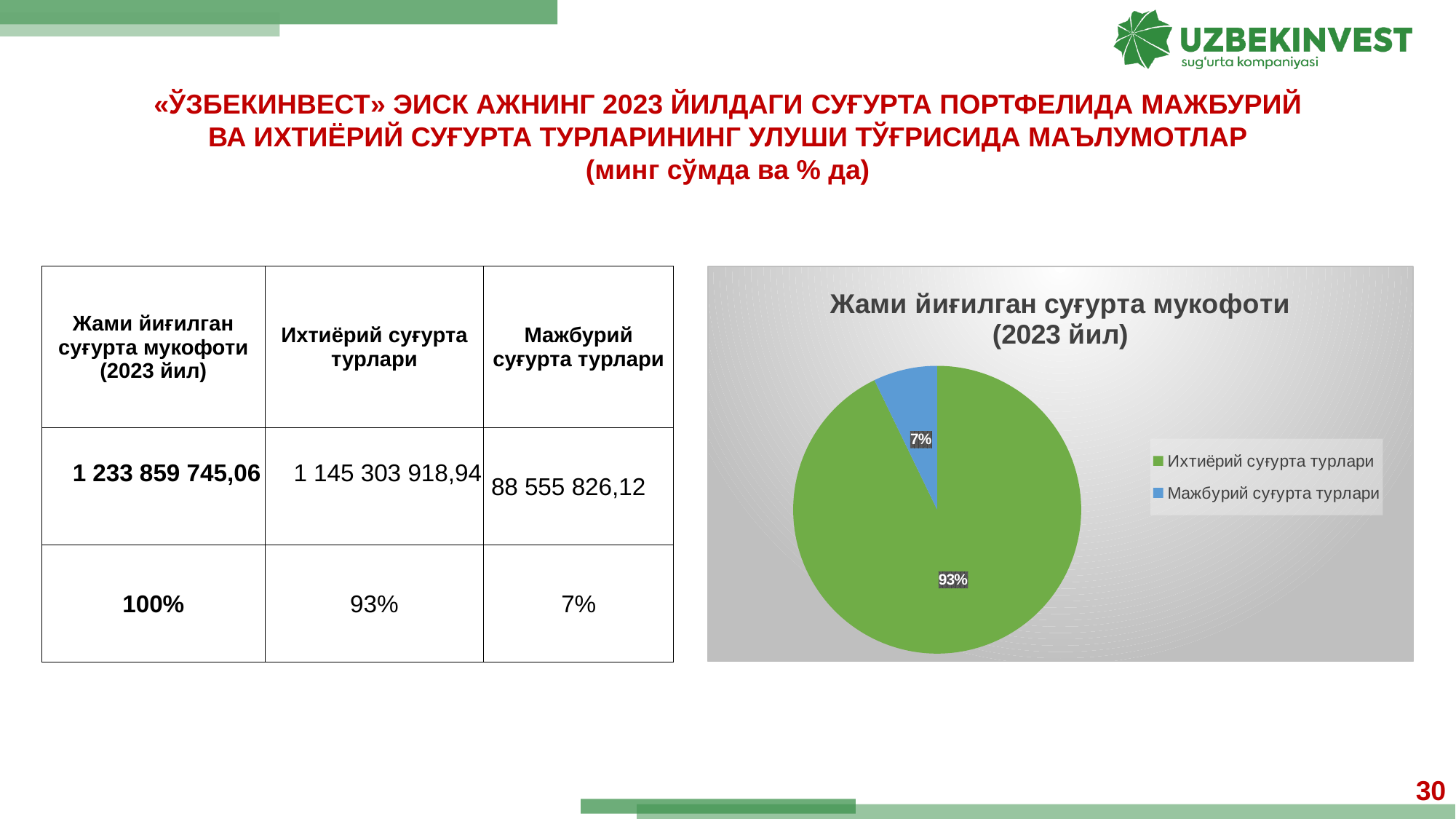
What share of the pie does Ихтиёрий суғурта турлари have? 93% What share of the pie does Мажбурий суғурта турлари have? 7% What is the difference in percentage points between the Ихтиёрий суғурта турлари slice and the Мажбурий суғурта турлари slice? 86 percentage points Which slice of the pie chart is the largest? Ихтиёрий суғурта турлари How many entries does the pie chart's legend list? 2 What is the title of the pie chart? Жами йиғилган суғурта мукофоти (2023 йил) Which is larger in the pie chart: Ихтиёрий суғурта турлари or Мажбурий суғурта турлари? Ихтиёрий суғурта турлари What colour is the Мажбурий суғурта турлари slice in the pie chart? blue What kind of chart is shown on the slide? pie chart Which slice of the pie chart is the smallest? Мажбурий суғурта турлари How many slices does the pie chart have? 2